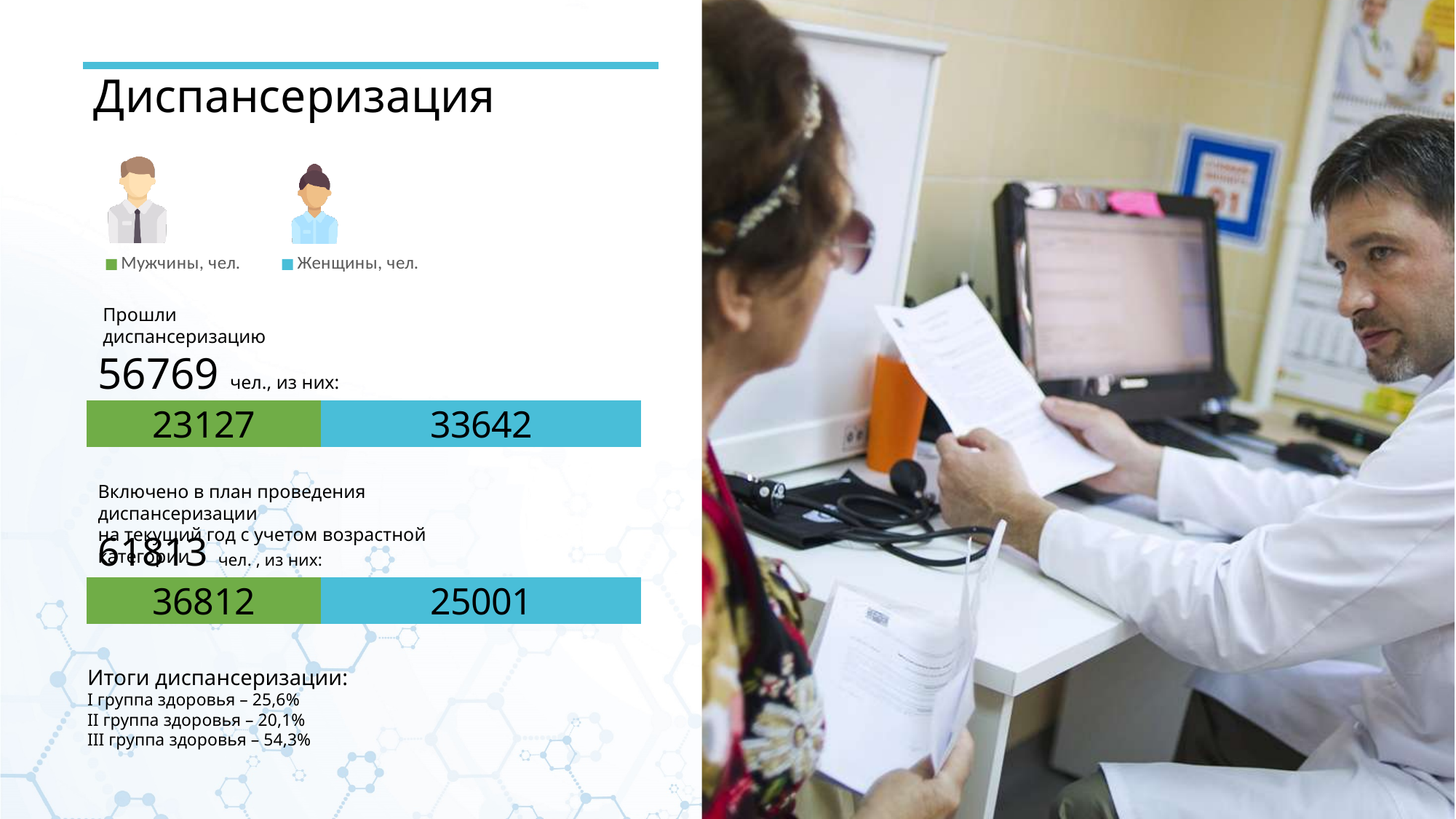
In the lower bar (Включено в план проведения диспансеризации), what is the value for Мужчины, чел.? 36812 How many series does the legend list? 2 Which colour represents Мужчины, чел. in the legend? Green In the upper bar (Прошли диспансеризацию), what is the value for Женщины, чел.? 33642 In the upper bar (Прошли диспансеризацию), what is the difference between Женщины and Мужчины? 10515 In the upper bar (Прошли диспансеризацию), what is the value for Мужчины, чел.? 23127 What is the total of the upper stacked bar (Прошли диспансеризацию)? 56769 What is the total of the lower stacked bar (Включено в план проведения диспансеризации)? 61813 In the lower bar (Включено в план проведения диспансеризации), which group is larger, Мужчины or Женщины? Мужчины In the lower bar (Включено в план проведения диспансеризации), what is the value for Женщины, чел.? 25001 In the lower bar (Включено в план проведения диспансеризации), what is the difference between Мужчины and Женщины? 11811 In the upper bar (Прошли диспансеризацию), which group is larger, Мужчины or Женщины? Женщины